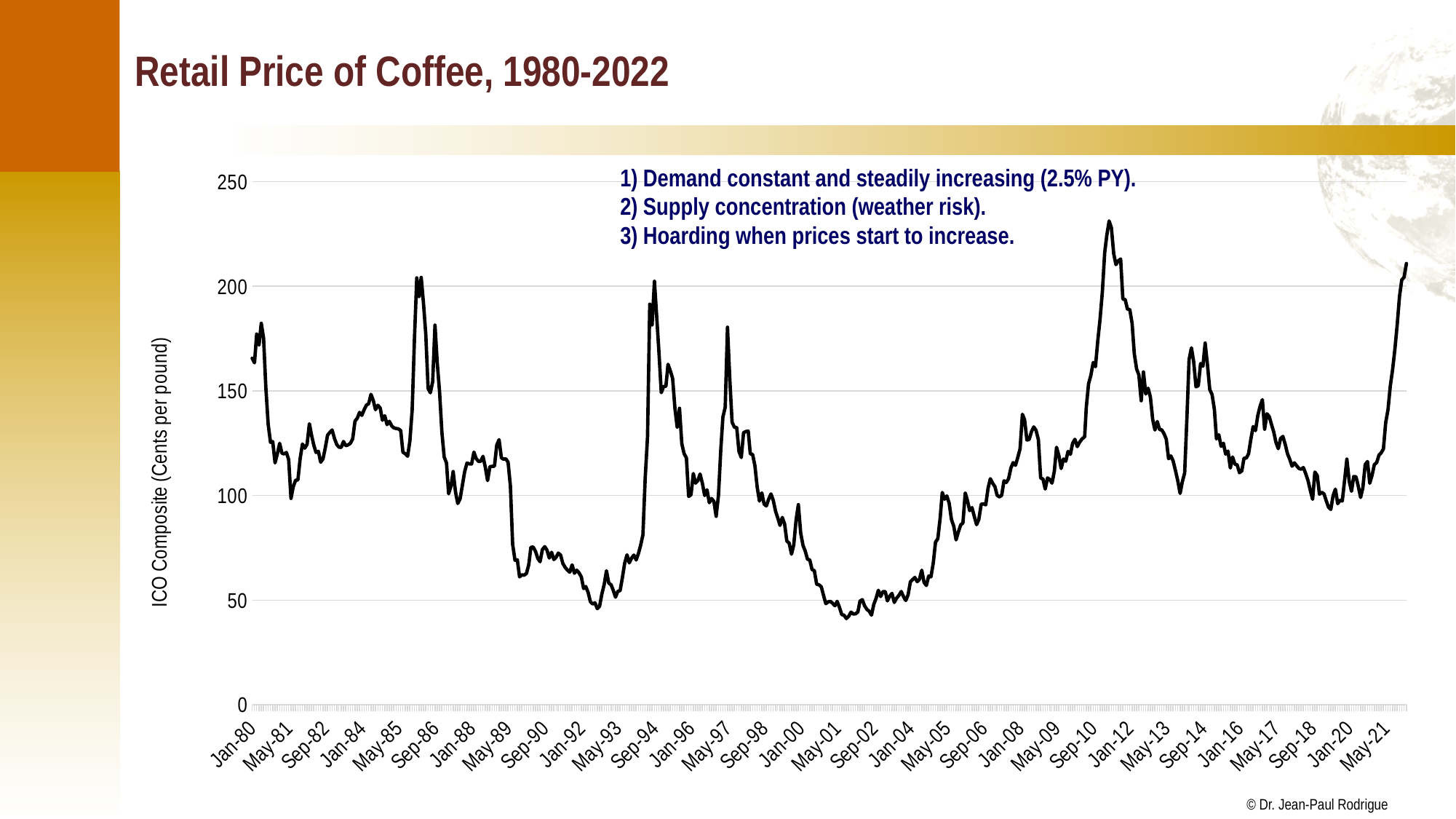
Is the peak value around Jan-12 greater or less than 200? greater Is the value around Jan-04 greater or less than 100? less Is the lowest point on the chart greater or less than 50? less What is the label of the vertical axis? ICO Composite (Cents per pound) What kind of chart is shown on the slide? Line chart How many data series are plotted on the chart? 1 Does the line rise or fall between Jan-12 and May-13? Fall What is the title of the chart? Retail Price of Coffee, 1980-2022 Does the line rise or fall between Sep-18 and May-21? Rise